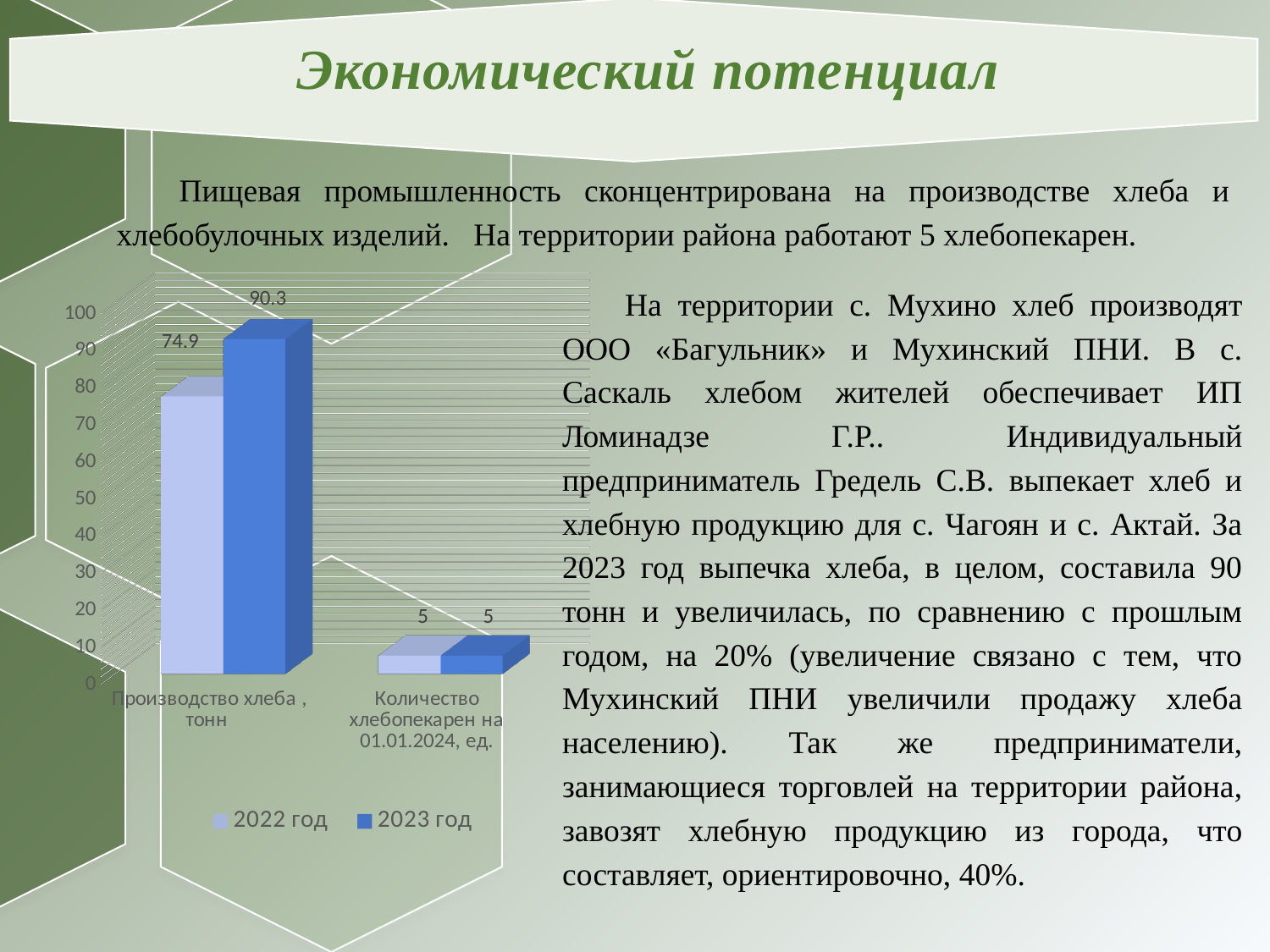
Which category has the highest value on the chart? Производство хлеба, тонн What is the value for 2023 год in the category Производство хлеба, тонн? 90.3 By how much does the 2023 год value exceed the 2022 год value in the category Производство хлеба, тонн? 15.4 How many series does the chart legend list? 2 Is the value for 2022 год in Производство хлеба, тонн greater or less than 80? less What is the value for 2022 год in the category Количество хлебопекарен на 01.01.2024, ед.? 5 What are the two series names listed in the chart legend? 2022 год and 2023 год What is the value for 2022 год in the category Производство хлеба, тонн? 74.9 What kind of chart is shown on the slide? bar chart How many categories are shown on the x axis of the chart? 2 What is the value for 2023 год in the category Количество хлебопекарен на 01.01.2024, ед.? 5 Which series has the larger value in the category Производство хлеба, тонн: 2022 год or 2023 год? 2023 год